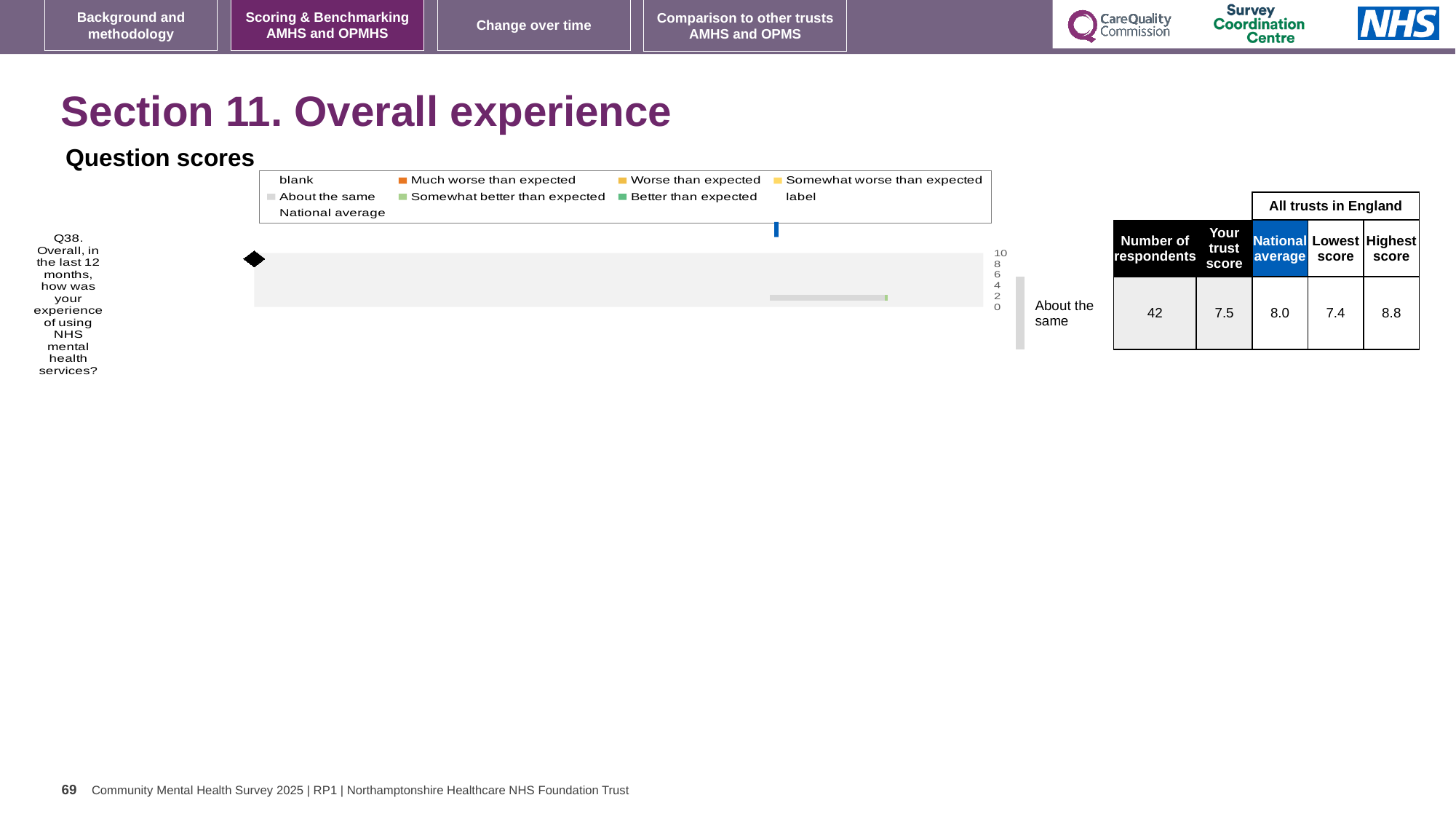
What is the difference between the highest and lowest scores among all trusts in England for Q38? 1.4 How many entries does the legend of the Question scores chart list? 9 How many respondents answered Q38 according to the table next to the Question scores chart? 42 Which is larger for Q38, the trust's score or the national average? national average What is the lowest score among all trusts in England for Q38? 7.4 What kind of chart is shown under "Question scores"? bar chart What is the highest score among all trusts in England for Q38? 8.8 What is the highest value shown on the axis of the Question scores chart? 10 How many questions (categories) are plotted in the Question scores chart? 1 What is the trust's score for Q38 shown alongside the Question scores chart? 7.5 What is the national average score for Q38 shown alongside the Question scores chart? 8.0 Which question is plotted in the Question scores chart? Q38. Overall, in the last 12 months, how was your experience of using NHS mental health services?